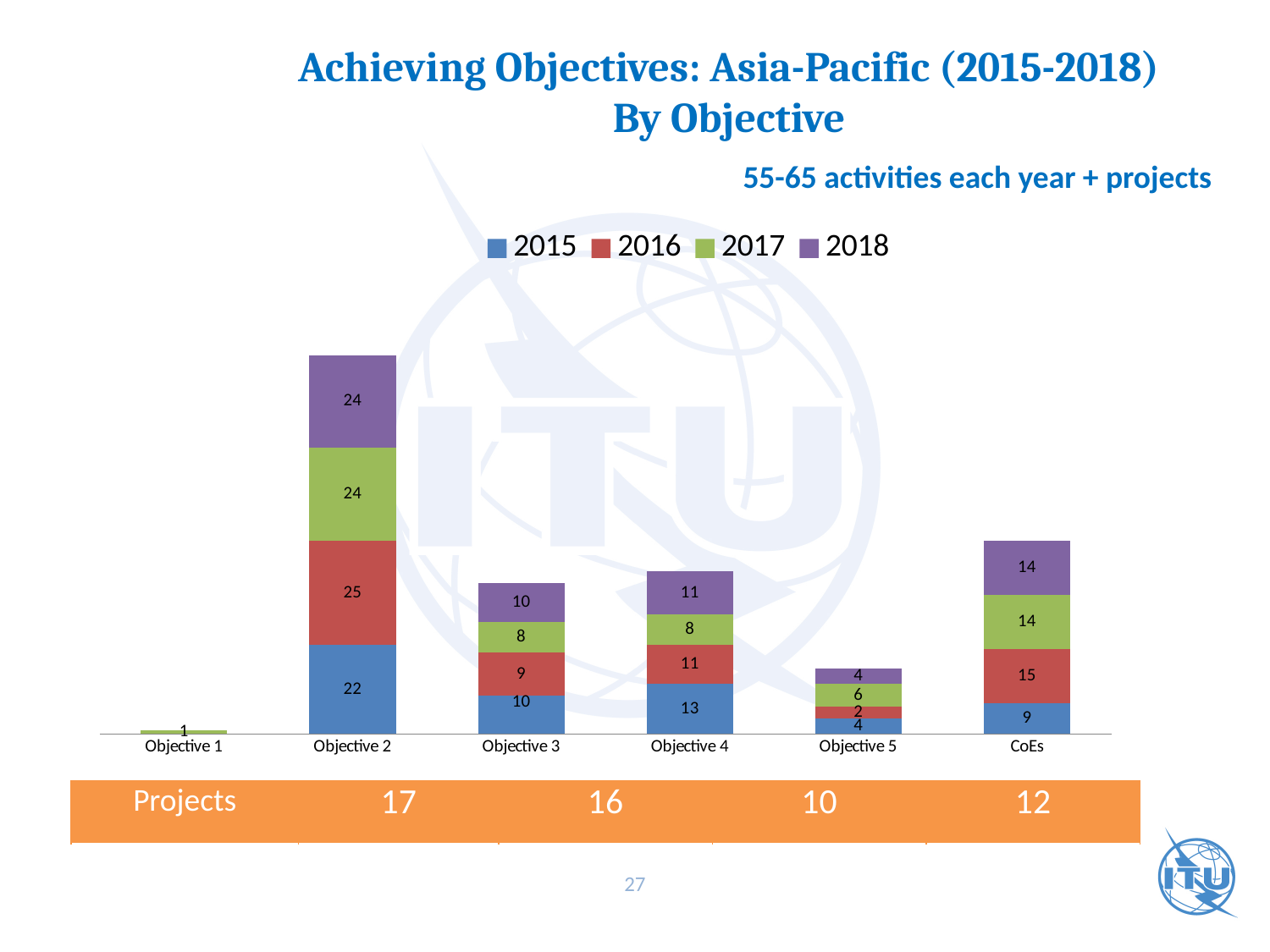
What is the total of the stacked bar for Objective 4? 43 Which is larger, the 2015 value for Objective 4 or the 2015 value for CoEs? Objective 4 How many categories are shown on the x axis? 6 What is the 2015 value for Objective 2? 22 What is the 2017 value for Objective 5? 6 What is the 2018 value for Objective 3? 10 Which category has the shortest stacked bar? Objective 1 Which category has the tallest stacked bar? Objective 2 How many series does the legend list? 4 What type of chart is shown on the slide? Stacked bar chart What is the 2016 value for CoEs? 15 What is the difference between the 2016 value for Objective 2 and the 2016 value for Objective 3? 16